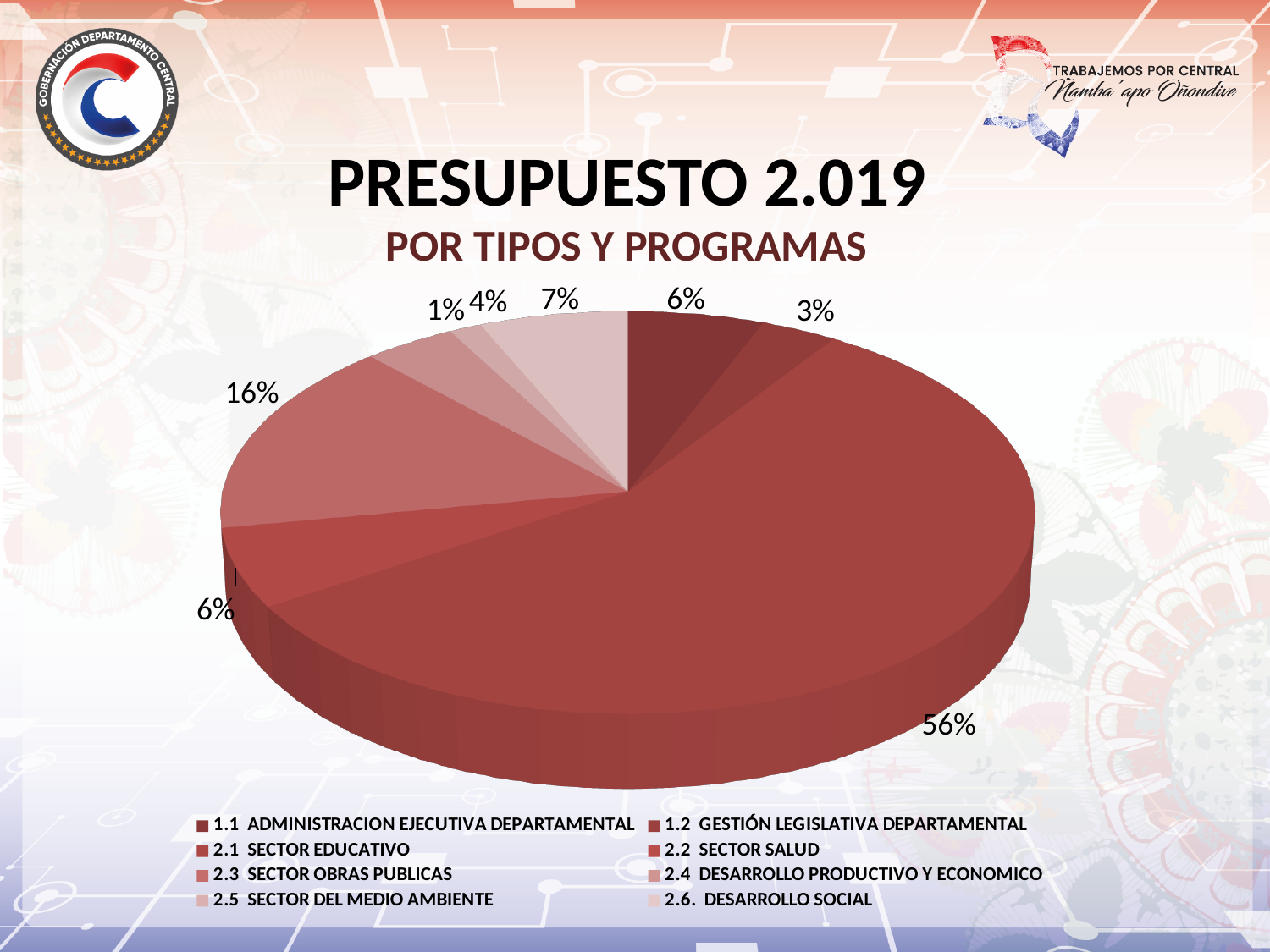
Which category has the largest share of the pie? 2.1 SECTOR EDUCATIVO What share of the pie does 2.1 SECTOR EDUCATIVO have? 56% Which category has the smallest share of the pie? 2.5 SECTOR DEL MEDIO AMBIENTE What kind of chart is shown on the slide? pie chart How many slices does the pie chart have? 8 What is the difference between the shares of 2.1 SECTOR EDUCATIVO and 2.3 SECTOR OBRAS PUBLICAS? 40% What share of the pie does 2.3 SECTOR OBRAS PUBLICAS have? 16% What is the value shown for 1.2 GESTIÓN LEGISLATIVA DEPARTAMENTAL? 3% How many entries does the legend list? 8 What is the value shown for 2.6 DESARROLLO SOCIAL? 7% What is the main title of the chart on the slide? PRESUPUESTO 2.019 Which is larger, the share of 2.3 SECTOR OBRAS PUBLICAS or the share of 2.6 DESARROLLO SOCIAL? 2.3 SECTOR OBRAS PUBLICAS